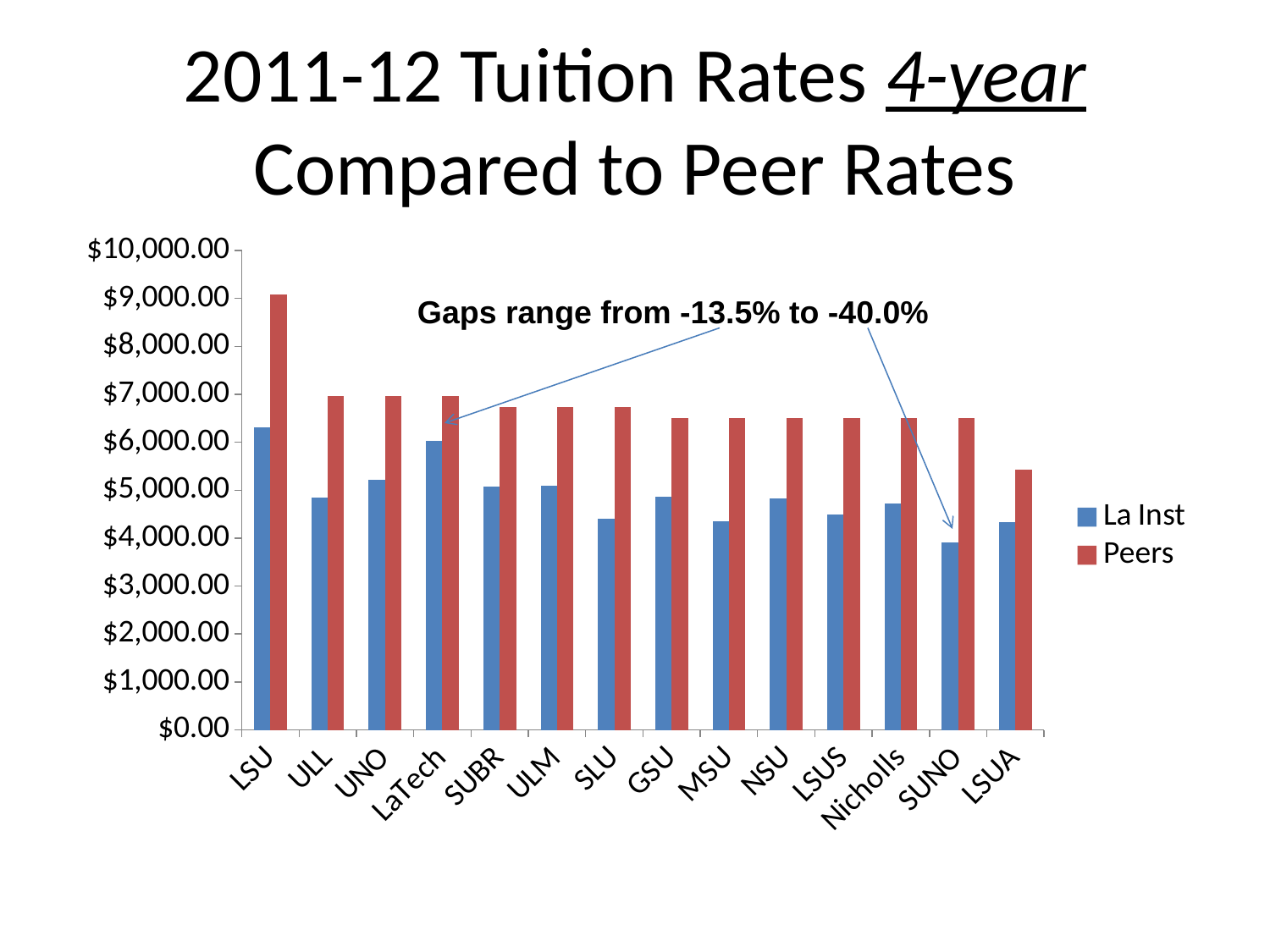
According to the annotation on the chart, what range do the gaps cover? -13.5% to -40.0% What kind of chart is shown on the slide? bar chart Which institution has the lowest Peers tuition rate? LSUA Which institution has the highest Peers tuition rate? LSU How many series does the chart's legend list? 2 Which institution has the highest La Inst tuition rate? LSU Is the La Inst value for SLU greater or less than $5,000.00? less Which is larger, the La Inst value for LSU or the La Inst value for LaTech? LSU Is the Peers value for LSUA greater or less than $5,000.00? greater Is the Peers value for LSU greater or less than $8,000.00? greater Which institution has the lowest La Inst tuition rate? SUNO How many institutions are shown on the x axis of the chart? 14